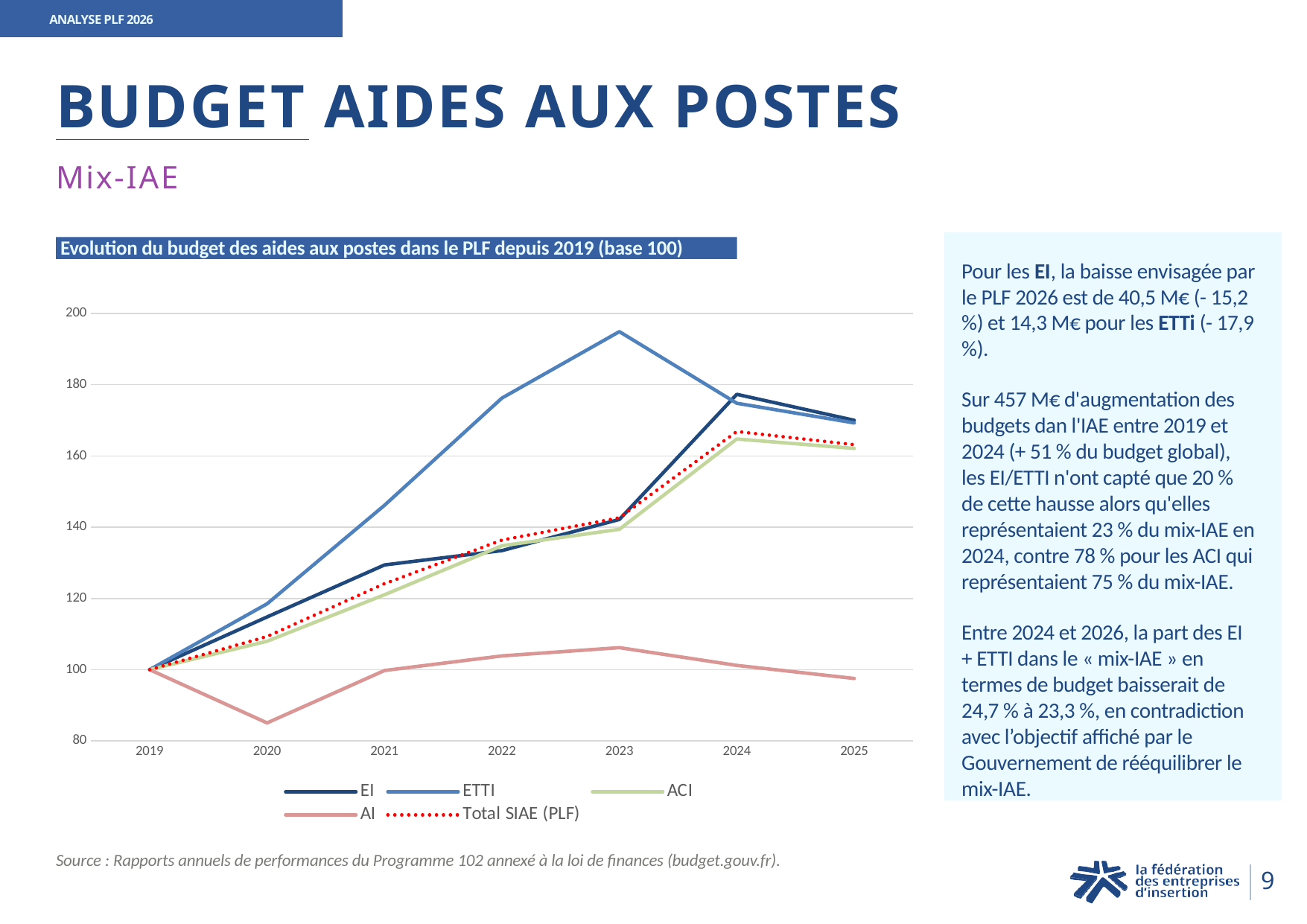
In 2022, which is larger, the value for ETTI or the value for EI? ETTI Is the value for AI in 2020 greater or less than 100? less What is the value of the EI series in 2019? 100 Which series has the lowest value in 2023? AI What kind of chart is shown on the slide? line chart How many series does the chart legend list? 5 Is the value for ETTI in 2023 greater or less than 180? greater What is the title of the chart? Evolution du budget des aides aux postes dans le PLF depuis 2019 (base 100) Does the ETTI series rise or fall between 2019 and 2023? rise Is the value for EI in 2021 greater or less than 120? greater Which series has the highest value in 2023? ETTI How many years are plotted along the x axis of the chart? 7